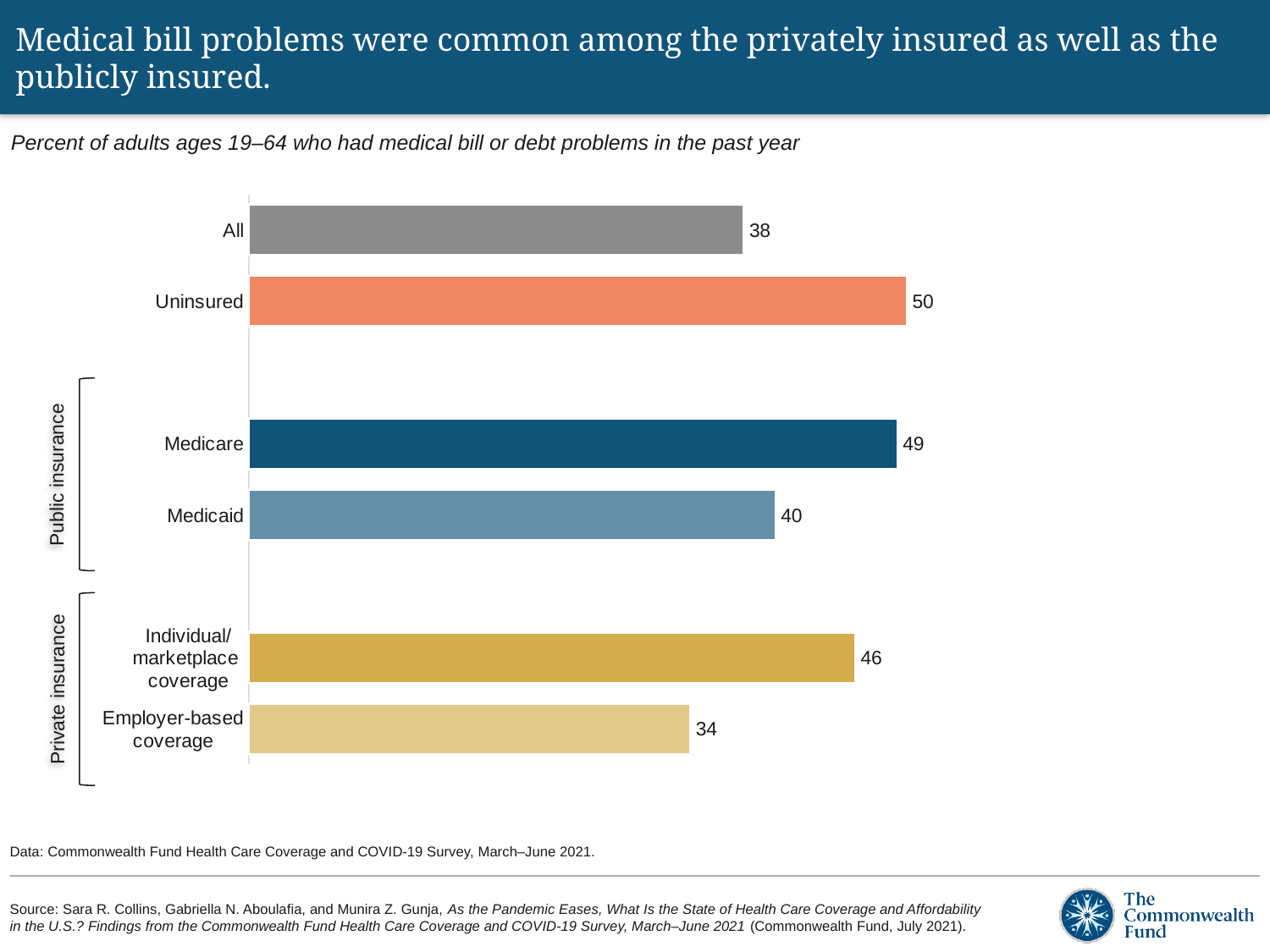
Which is larger, the value for Medicaid or the value for Individual/marketplace coverage? Individual/marketplace coverage What kind of chart is shown on the slide? Bar chart What is the value for Uninsured? 50 What is the difference between the values for Medicare and Medicaid? 9 Which two categories are grouped under the 'Public insurance' bracket? Medicare and Medicaid What is the value for Employer-based coverage? 34 Which category has the highest value? Uninsured What is the value for Medicare? 49 Which category has the lowest value? Employer-based coverage What is the value for All adults? 38 How many categories are plotted in the chart? 6 What is the difference between the values for Individual/marketplace coverage and Employer-based coverage? 12